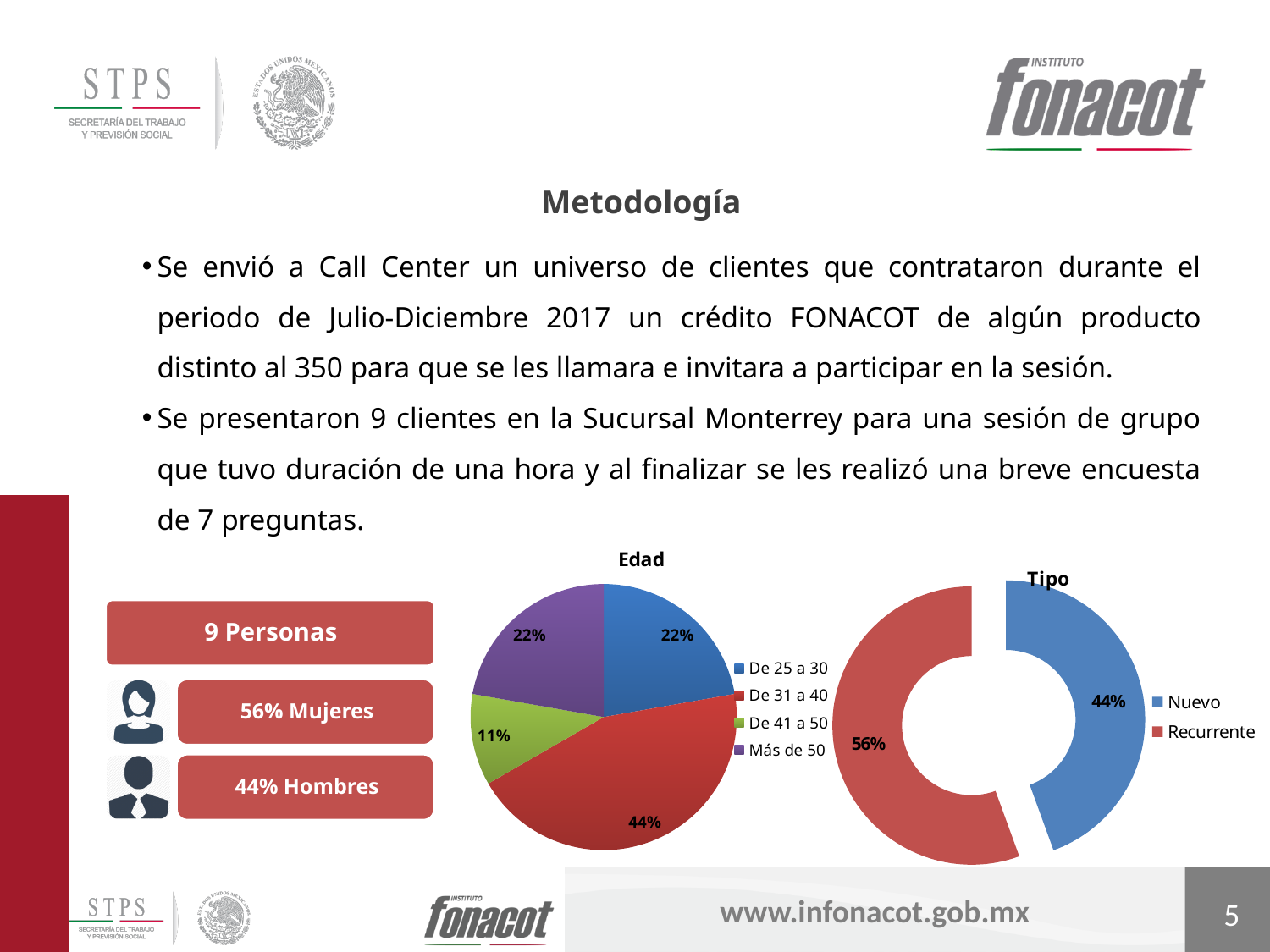
In the 'Edad' chart, what is the difference in percentage points between 'De 31 a 40' and 'De 41 a 50'? 33 What kind of chart is the 'Edad' chart? Pie chart How many categories does the legend of the 'Edad' chart list? 4 In the 'Tipo' chart, what colour represents 'Nuevo'? Blue In the 'Edad' chart, which age group has the largest share? De 31 a 40 In the 'Edad' chart, what percentage is shown for 'De 41 a 50'? 11% In the 'Tipo' chart, what percentage is shown for 'Nuevo'? 44% In the 'Tipo' chart, what percentage is shown for 'Recurrente'? 56% In the 'Edad' chart, which age group has the smallest share? De 41 a 50 In the 'Tipo' chart, which category is larger, 'Nuevo' or 'Recurrente'? Recurrente In the 'Edad' chart, what percentage is shown for 'Más de 50'? 22% In the 'Edad' chart, what percentage is shown for 'De 31 a 40'? 44%